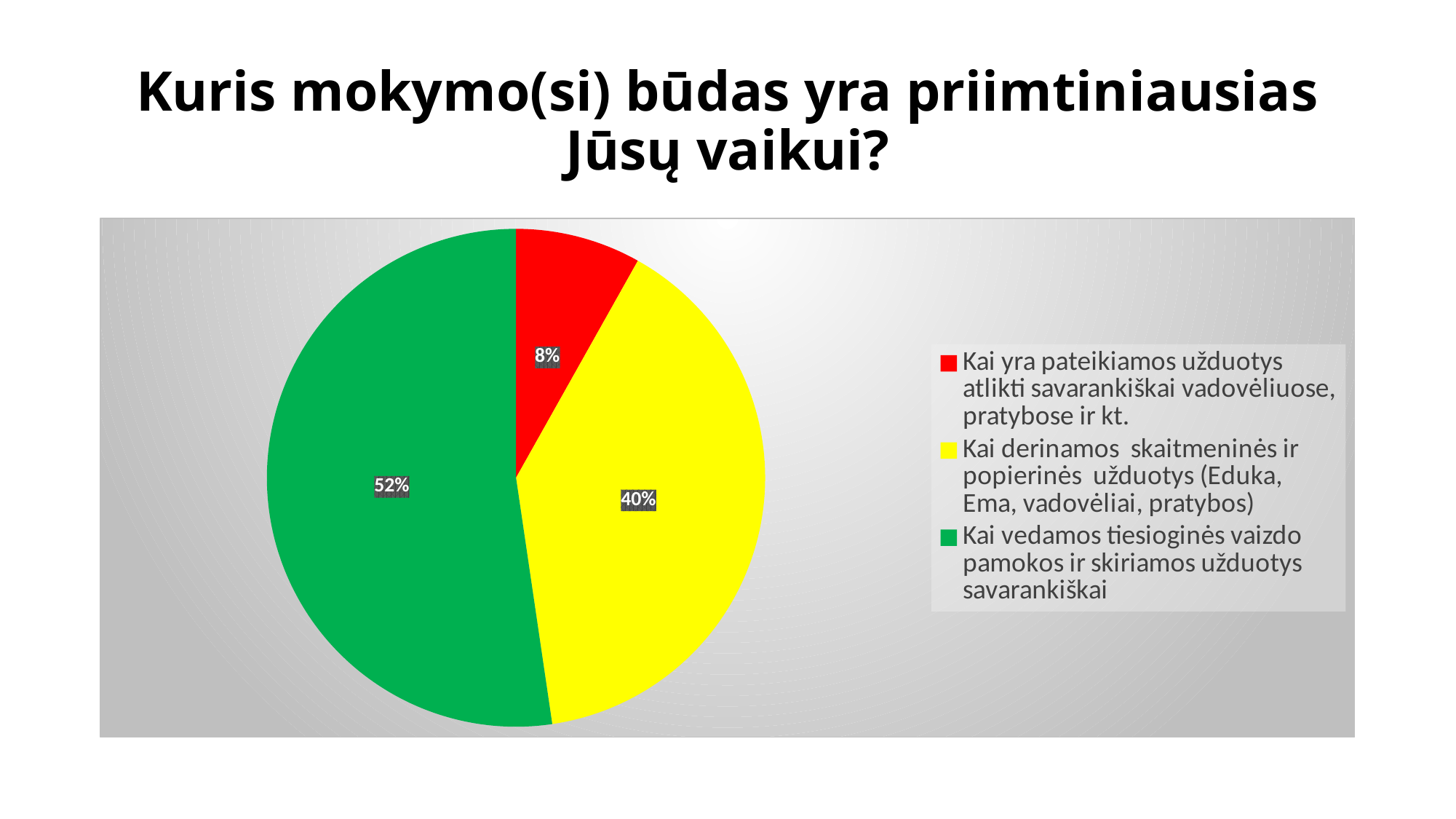
What is the difference in percentage points between the yellow slice (40%) and the red slice (8%)? 32 What share of the pie is labelled for "Kai yra pateikiamos užduotys atlikti savarankiškai vadovėliuose, pratybose ir kt."? 8% What colour is the slice for "Kai vedamos tiesioginės vaizdo pamokos ir skiriamos užduotys savarankiškai"? green How many entries does the legend list? 3 Which category has the smallest slice of the pie? Kai yra pateikiamos užduotys atlikti savarankiškai vadovėliuose, pratybose ir kt. Which category has the largest slice of the pie? Kai vedamos tiesioginės vaizdo pamokos ir skiriamos užduotys savarankiškai What kind of chart is shown on the slide? pie chart What share of the pie is labelled for "Kai derinamos skaitmeninės ir popierinės užduotys (Eduka, Ema, vadovėliai, pratybos)"? 40% What is the difference in percentage points between the green slice (52%) and the yellow slice (40%)? 12 What share of the pie is labelled for "Kai vedamos tiesioginės vaizdo pamokos ir skiriamos užduotys savarankiškai"? 52% How many slices does the pie chart have? 3 Which is larger: the share for "Kai derinamos skaitmeninės ir popierinės užduotys" or the share for "Kai yra pateikiamos užduotys atlikti savarankiškai vadovėliuose, pratybose ir kt."? Kai derinamos skaitmeninės ir popierinės užduotys